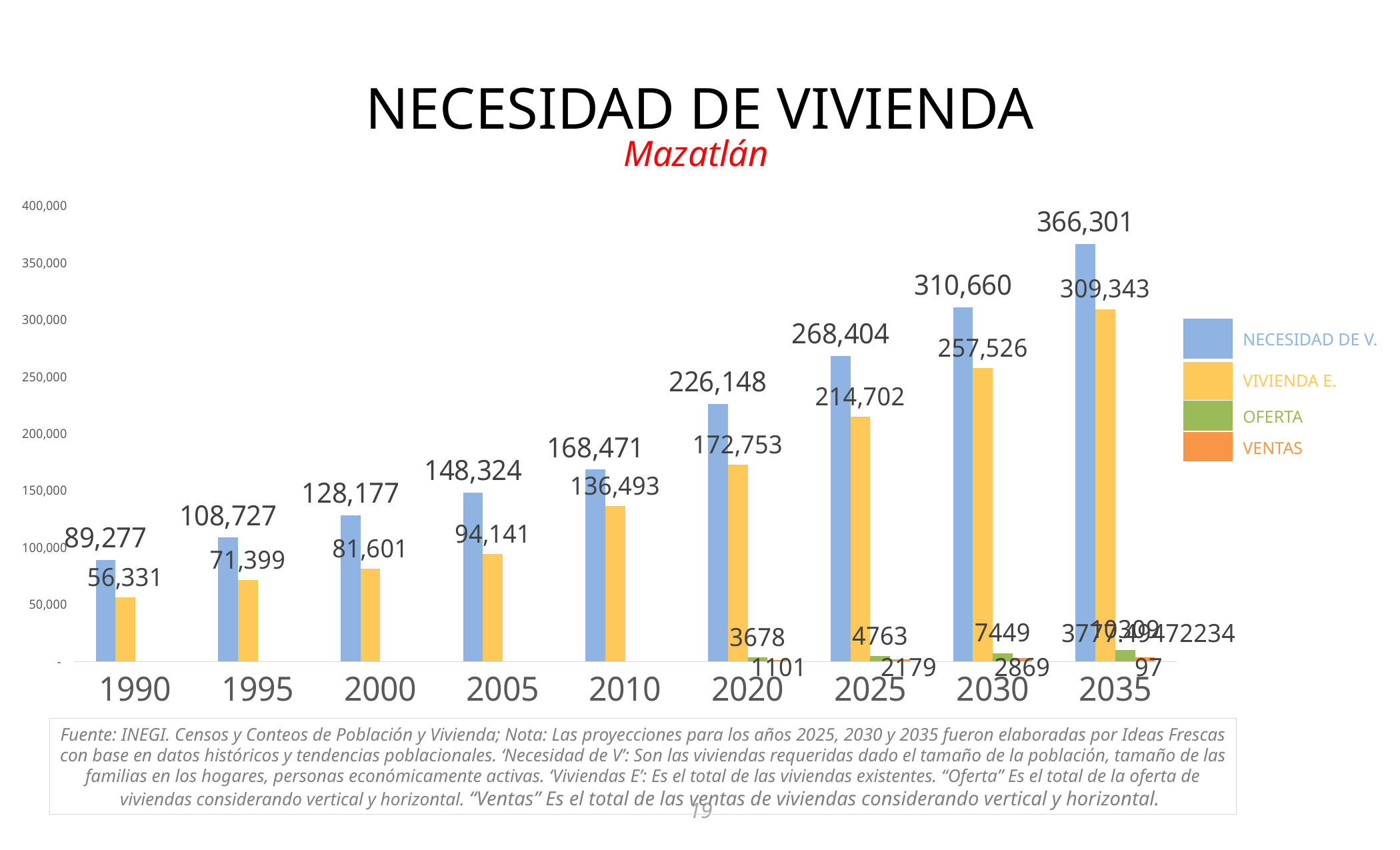
How many years are shown on the x axis? 9 What is the value of NECESIDAD DE V. for 2010? 168,471 What is the OFERTA value for 2030? 7449 What kind of chart is shown on the slide? Bar chart Which year has the highest NECESIDAD DE V. value? 2035 In 2020, which is larger: NECESIDAD DE V. or VIVIENDA E.? NECESIDAD DE V. What is the difference between NECESIDAD DE V. and VIVIENDA E. in 2035? 56,958 What is the value of VIVIENDA E. for 2025? 214,702 Do the NECESIDAD DE V. values rise or fall from 1990 to 2035? Rise How many series does the legend list? 4 Which year has the lowest VIVIENDA E. value? 1990 Which series is shown in green in the legend? OFERTA